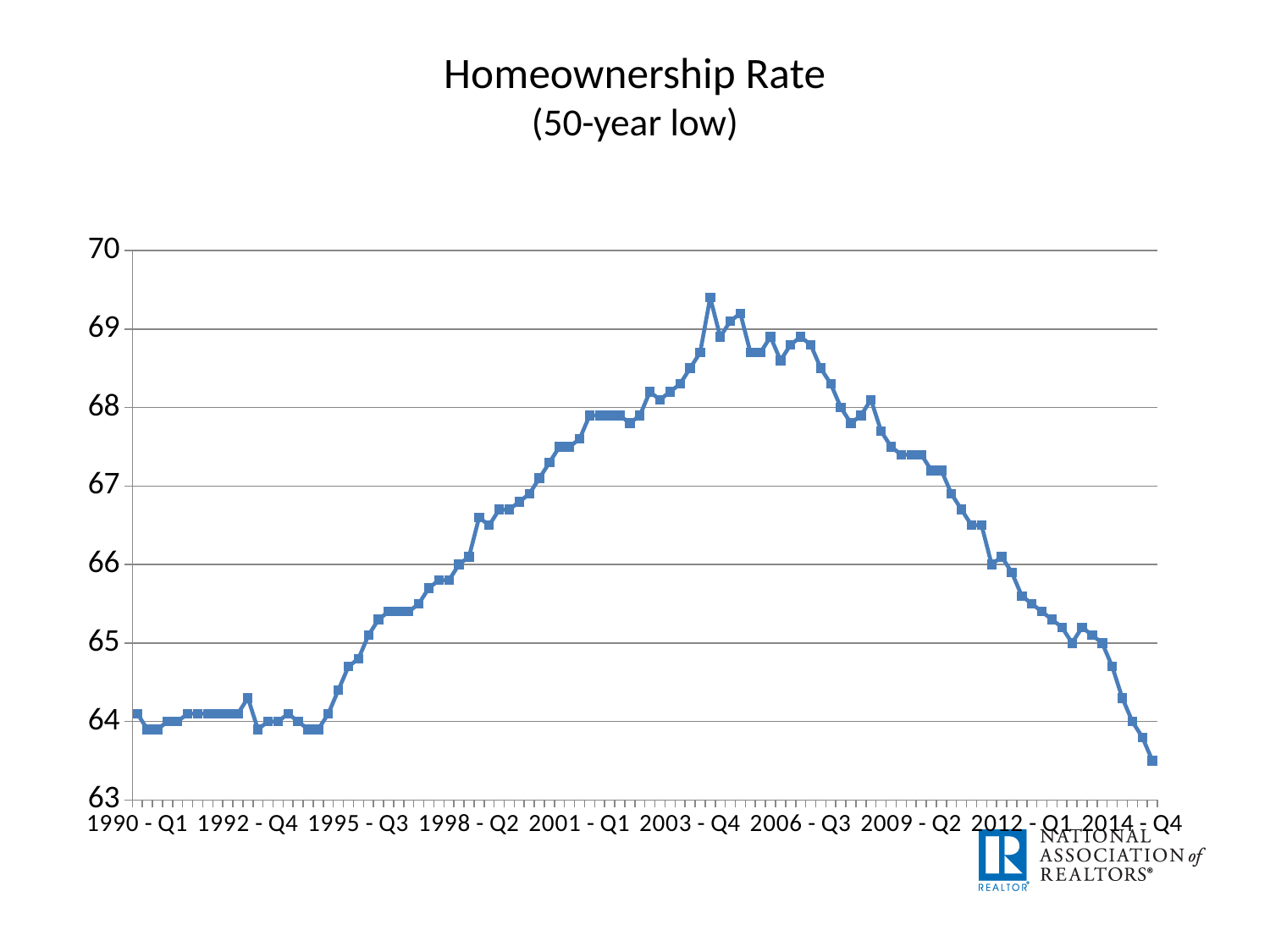
Is the value for 2009 - Q2 greater or less than 67? greater Is the value for 2006 - Q3 greater or less than 68? greater Is the value for 2001 - Q1 greater or less than 67? greater What is the title of the chart? Homeownership Rate (50-year low) How many lines (series) are plotted on the chart? 1 What kind of chart is shown on the slide? line chart Does the homeownership rate rise or fall between 2006 - Q3 and 2014 - Q4? fall Which is larger, the value for 2006 - Q3 or the value for 1990 - Q1? 2006 - Q3